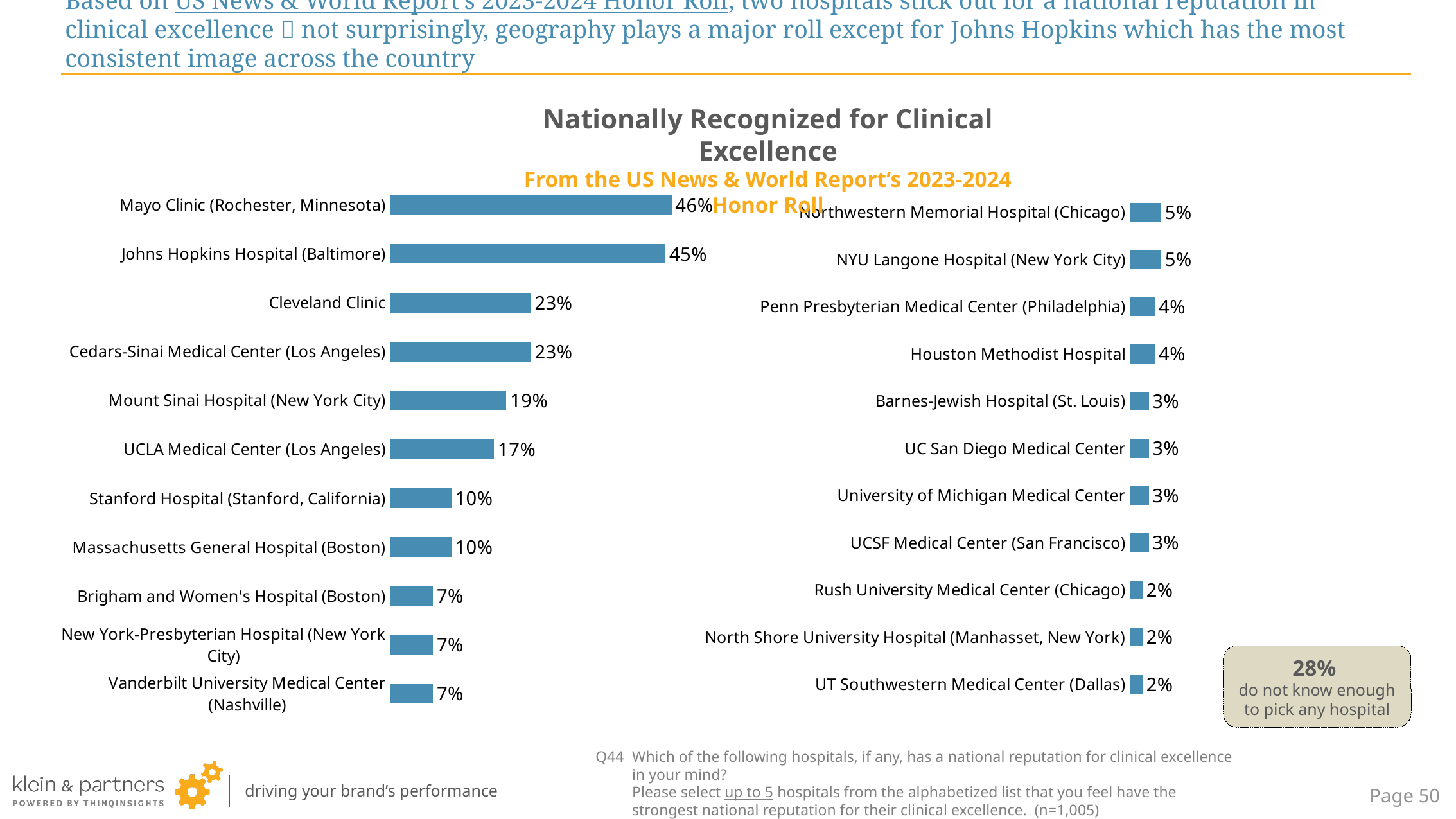
In the right chart, what percentage is shown for UT Southwestern Medical Center (Dallas)? 2% In the left chart, which is larger: the value for Mount Sinai Hospital (New York City) or UCLA Medical Center (Los Angeles)? Mount Sinai Hospital (New York City) What type of chart is used on this slide? Bar chart In the left chart, what is the difference between the percentages for Mayo Clinic (Rochester, Minnesota) and Cleveland Clinic? 23 percentage points What percentage of respondents do not know enough to pick any hospital, according to the box on the slide? 28% In the left chart, which hospital has the highest percentage? Mayo Clinic (Rochester, Minnesota) How many hospitals are listed in the right chart? 11 In the right chart, which hospital has the highest percentage? Northwestern Memorial Hospital (Chicago) and NYU Langone Hospital (New York City), both 5% How many hospitals are listed in the left chart? 11 In the left chart, what percentage is shown for Johns Hopkins Hospital (Baltimore)? 45% In the left chart, what percentage is shown for Mayo Clinic (Rochester, Minnesota)? 46% In the right chart, what percentage is shown for Penn Presbyterian Medical Center (Philadelphia)? 4%